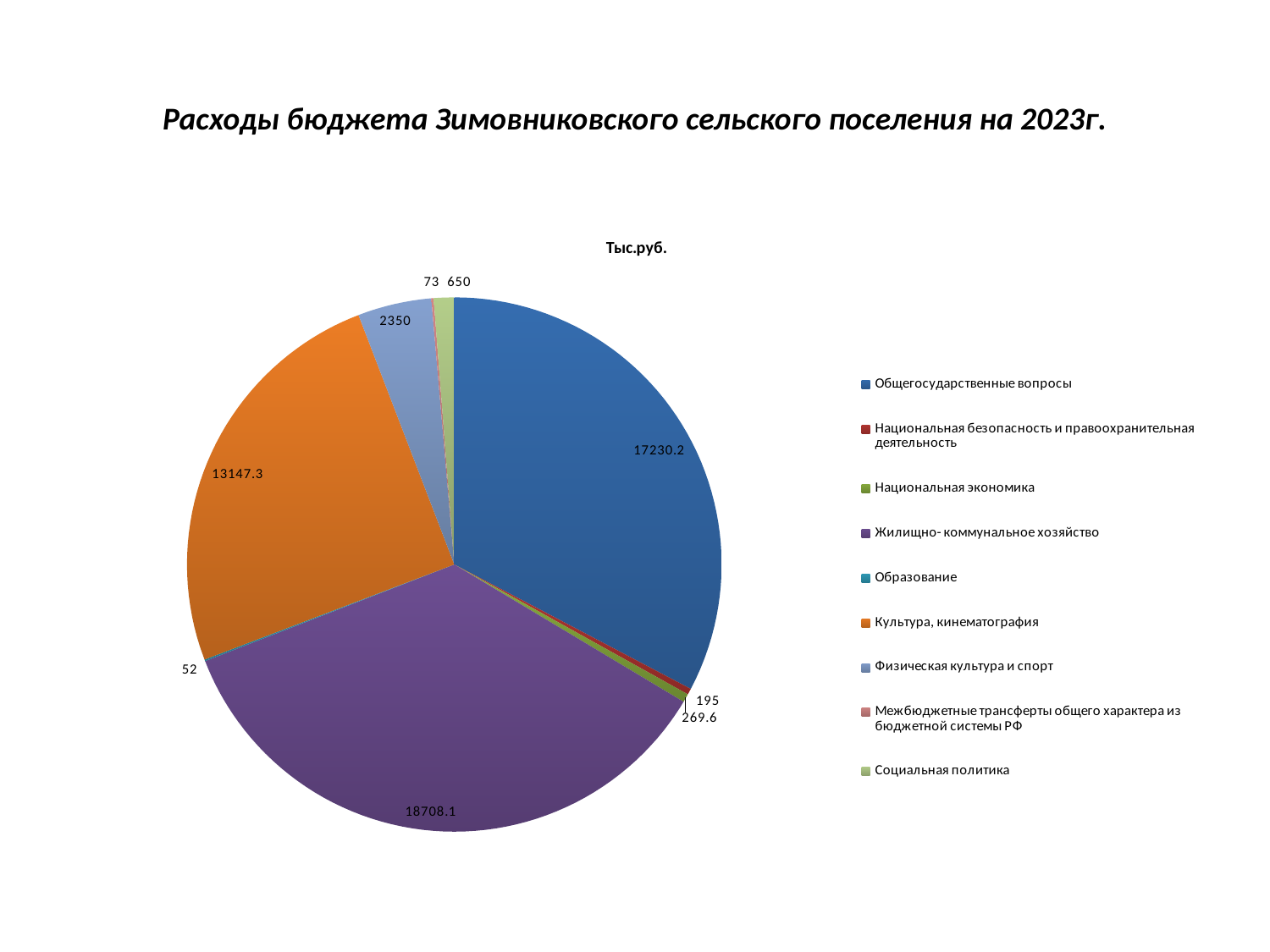
Which category has the smallest slice of the pie? Образование What is the value for Культура, кинематография? 13147.3 What is the value for Образование? 52 What is the value for Жилищно- коммунальное хозяйство? 18708.1 What unit is given in the chart title? Тыс.руб. What is the difference between the values for Жилищно- коммунальное хозяйство and Общегосударственные вопросы? 1477.9 How many categories does the legend list? 9 Which category has the largest slice of the pie? Жилищно- коммунальное хозяйство What is the value for Физическая культура и спорт? 2350 Which is larger: the value for Социальная политика or the value for Национальная экономика? Социальная политика What type of chart is shown on the slide? pie chart What is the value for Общегосударственные вопросы? 17230.2